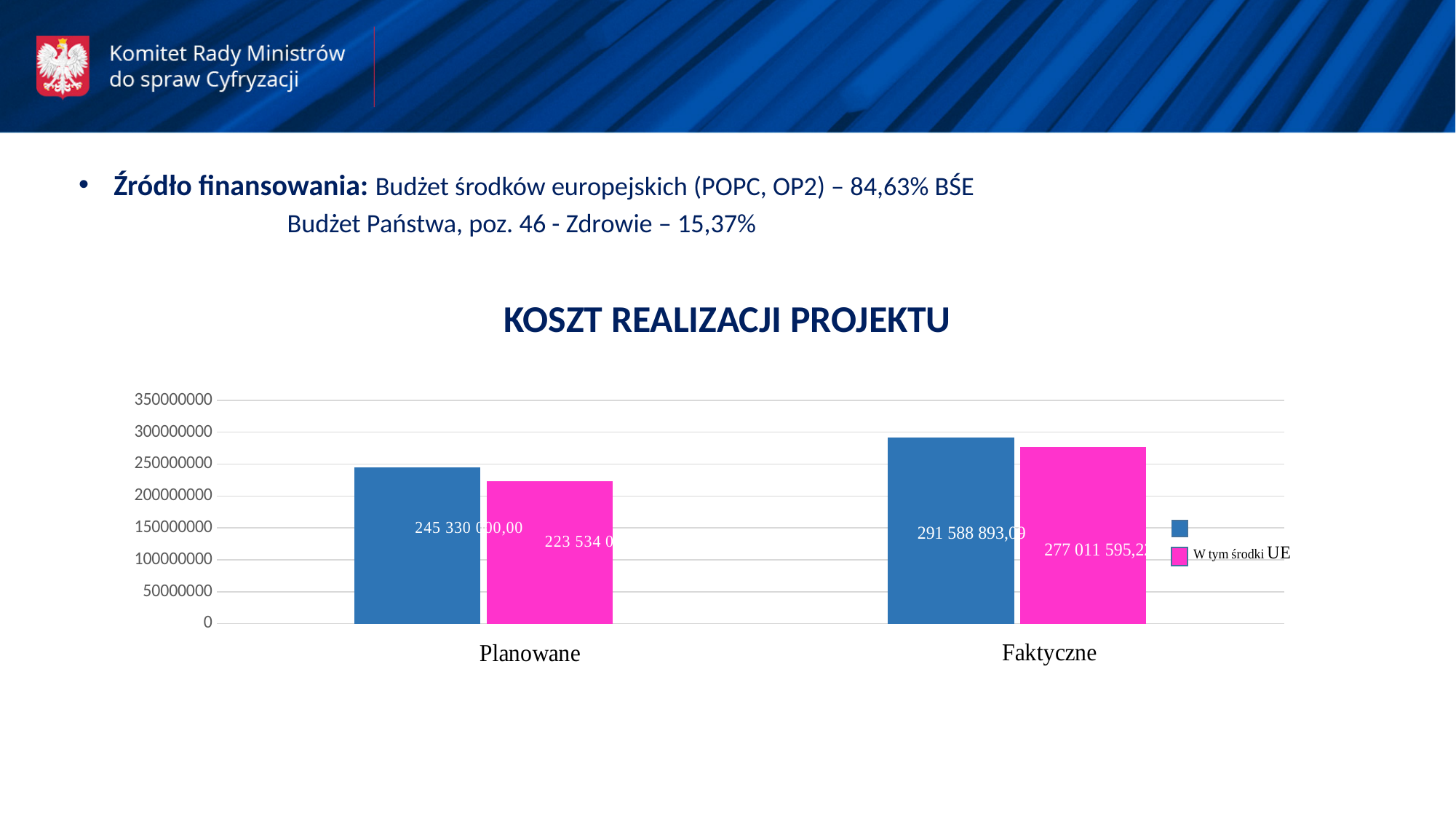
How many categories are shown on the x axis of the chart? 2 How many series does the chart's legend list? 2 Which category has the higher value for the blue (first) series, Planowane or Faktyczne? Faktyczne Is the value of the W tym środki UE bar for Faktyczne greater or less than 250000000? greater Is the value of the blue (first) bar for Faktyczne greater or less than 300000000? less What is the title of the chart? KOSZT REALIZACJI PROJEKTU Is the value of the W tym środki UE bar for Planowane greater or less than 250000000? less What kind of chart is shown under the title KOSZT REALIZACJI PROJEKTU? bar chart Do the values rise or fall from Planowane to Faktyczne? rise Within the Faktyczne category, which bar is taller, the blue (first) series or W tym środki UE? the blue (first) series Which bar in the chart is the lowest? W tym środki UE for Planowane What is the value of the blue (first) bar for Planowane? 245 330 000,00